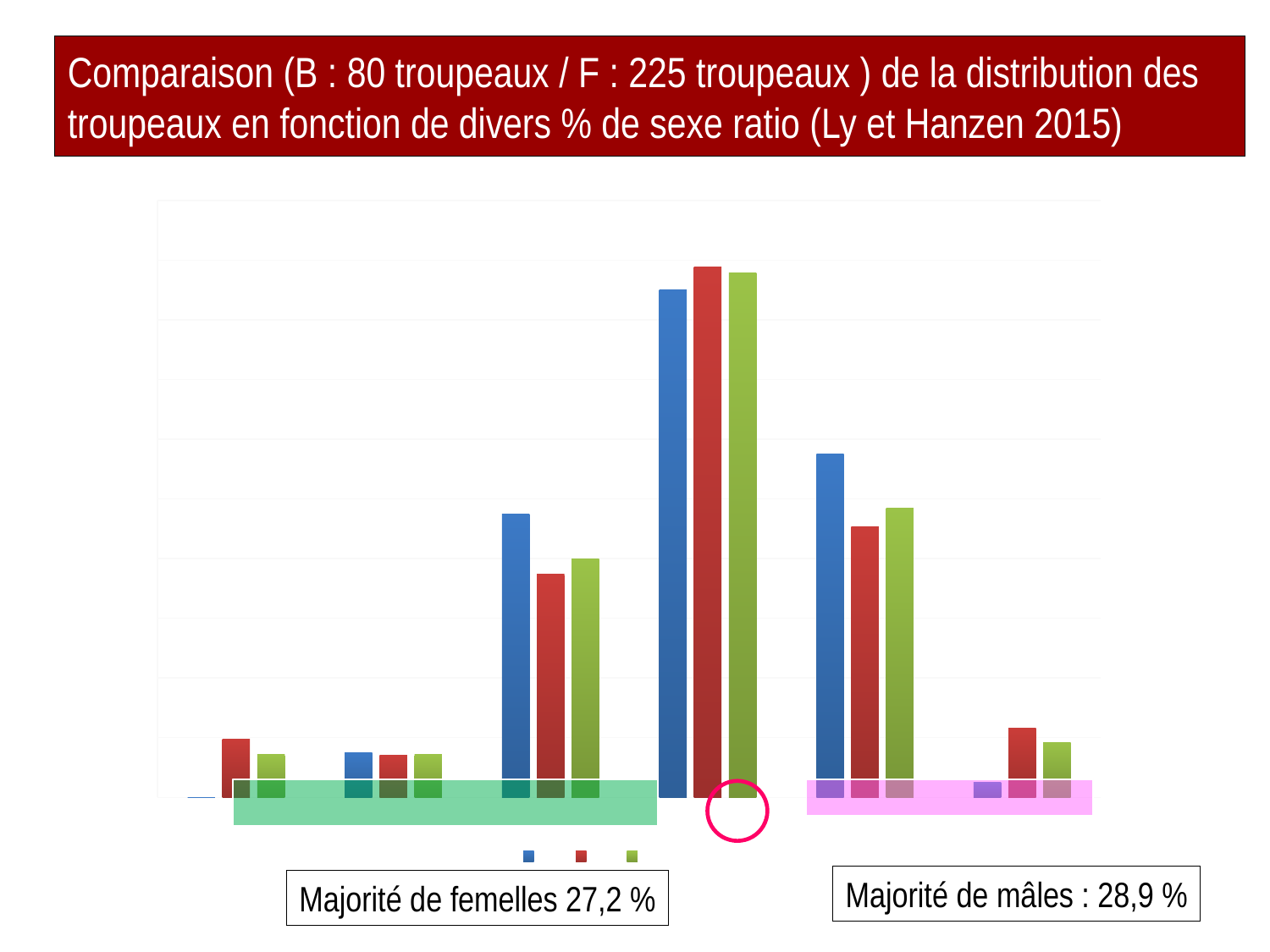
In the third group of bars from the left, which bar is taller, the blue one or the green one? the blue one Which group of bars, counting from the left, contains the tallest bars? the fourth group Do the bar heights rise steadily from left to right across the chart? no In the sixth group of bars from the left, which bar is taller, the red one or the green one? the red one What kind of chart is shown on the slide? bar chart In the fifth group of bars from the left, which bar is taller, the blue one or the red one? the blue one How many series does the legend below the chart list? 3 What colour is the tallest bar on the chart? red What percentage is given in the text box labelled 'Majorité de mâles' below the chart? 28,9 % How many groups of bars are plotted along the x axis? 6